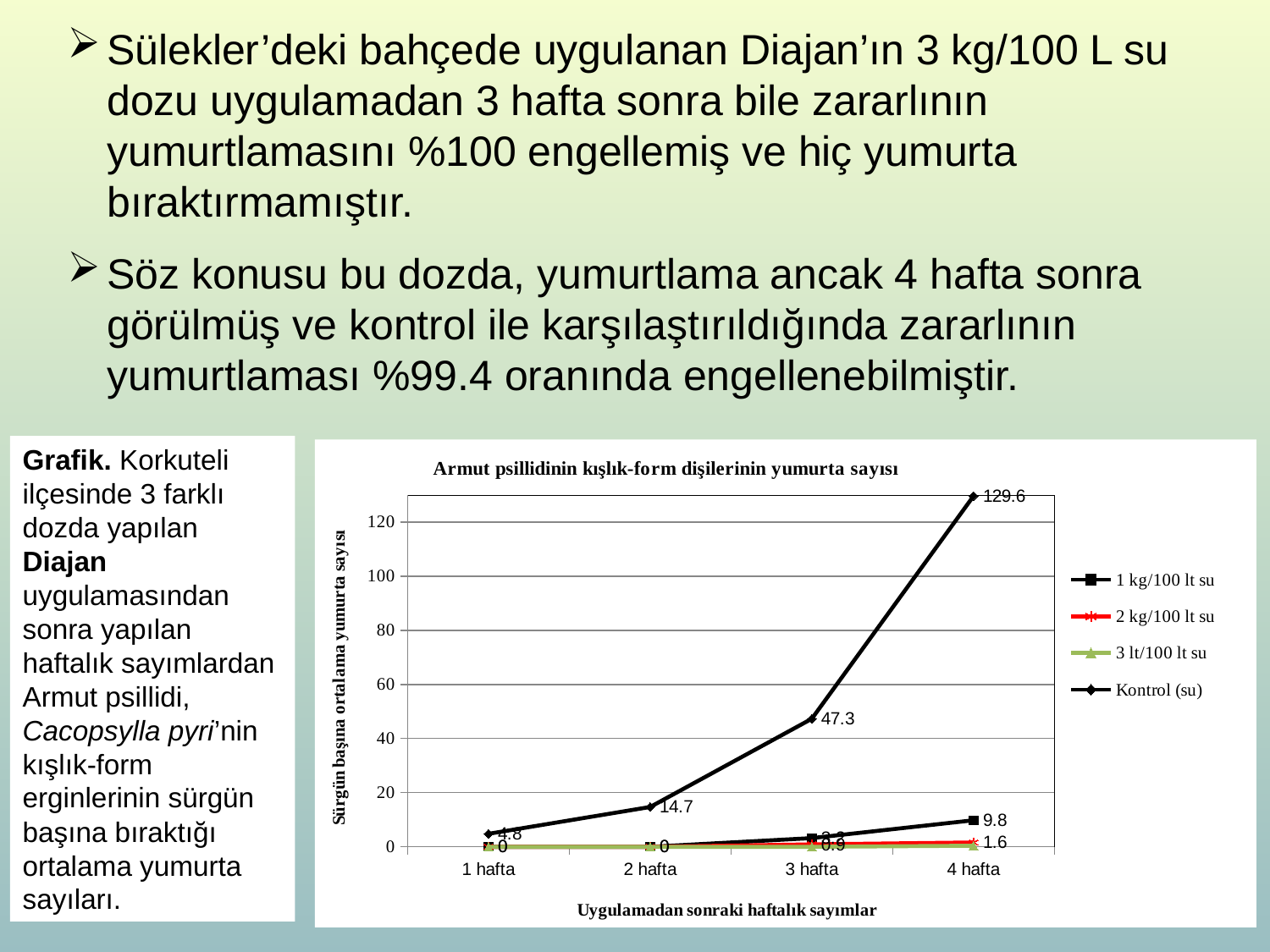
How many series does the chart legend list? 4 How many weekly count categories are shown on the x axis? 4 What type of chart is shown on the slide? line chart What is the value for Kontrol (su) at 3 hafta? 47.3 At which week is the Kontrol (su) value highest? 4 hafta Does the Kontrol (su) series rise or fall from 1 hafta to 4 hafta? rise Which is larger at 4 hafta: Kontrol (su) or 1 kg/100 lt su? Kontrol (su) What is the difference between the Kontrol (su) values at 4 hafta and 3 hafta? 82.3 What is the value for 1 kg/100 lt su at 4 hafta? 9.8 What is the value for Kontrol (su) at 4 hafta? 129.6 What is the value for 2 kg/100 lt su at 4 hafta? 1.6 What is the value for Kontrol (su) at 2 hafta? 14.7